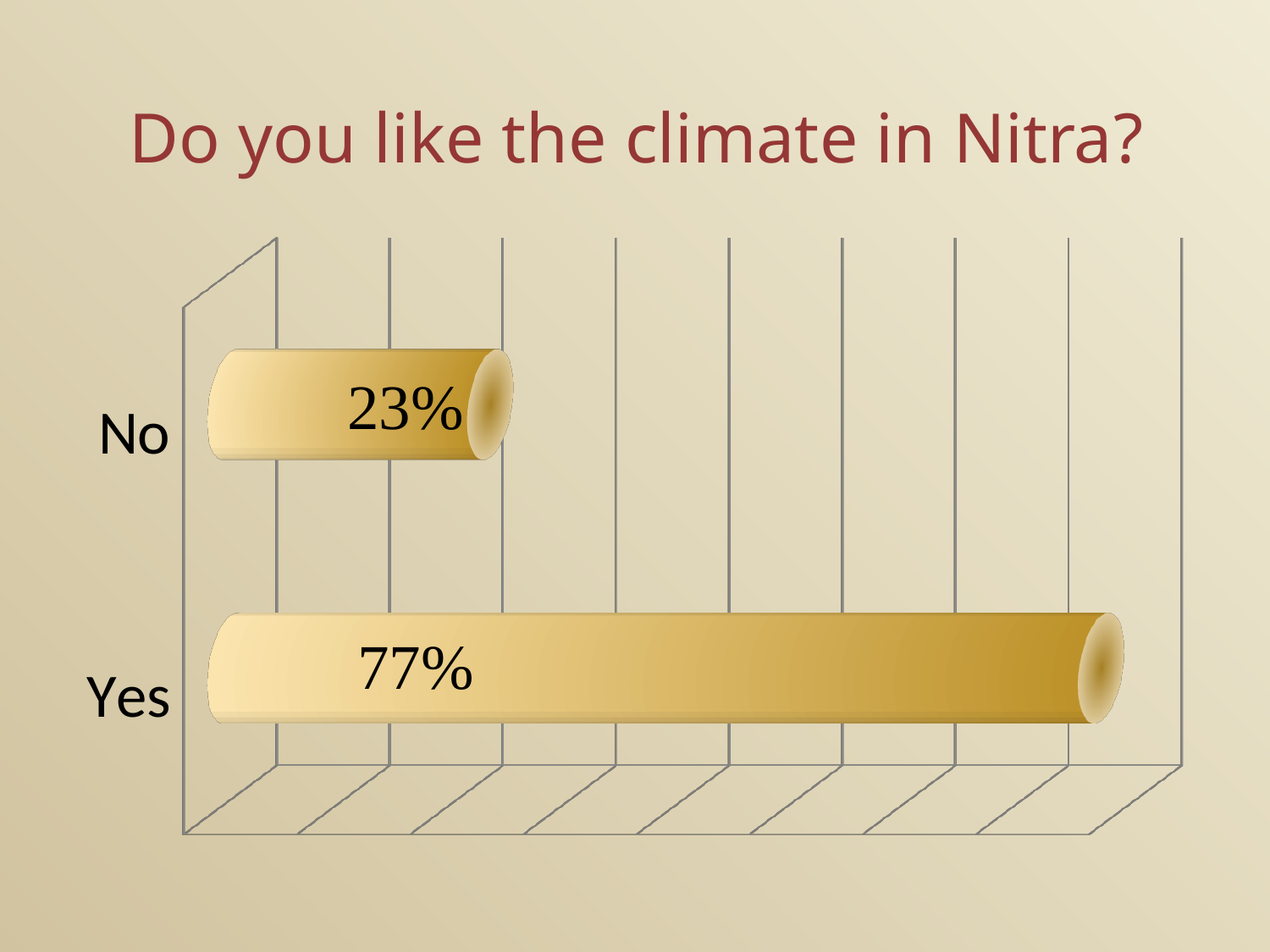
Is the value for No larger or smaller than the value for Yes? smaller Are the bars in the chart oriented horizontally or vertically? horizontally What kind of chart is shown on the slide? bar chart How many response categories are shown in the chart? 2 Which response has the higher value, Yes or No? Yes What is the difference in percentage points between the Yes and No responses? 54 What percentage of respondents answered "No"? 23% What is the title of the slide? Do you like the climate in Nitra? What is the total of the Yes and No percentages? 100% What percentage of respondents answered "Yes" to liking the climate in Nitra? 77% Which response has the lowest value? No